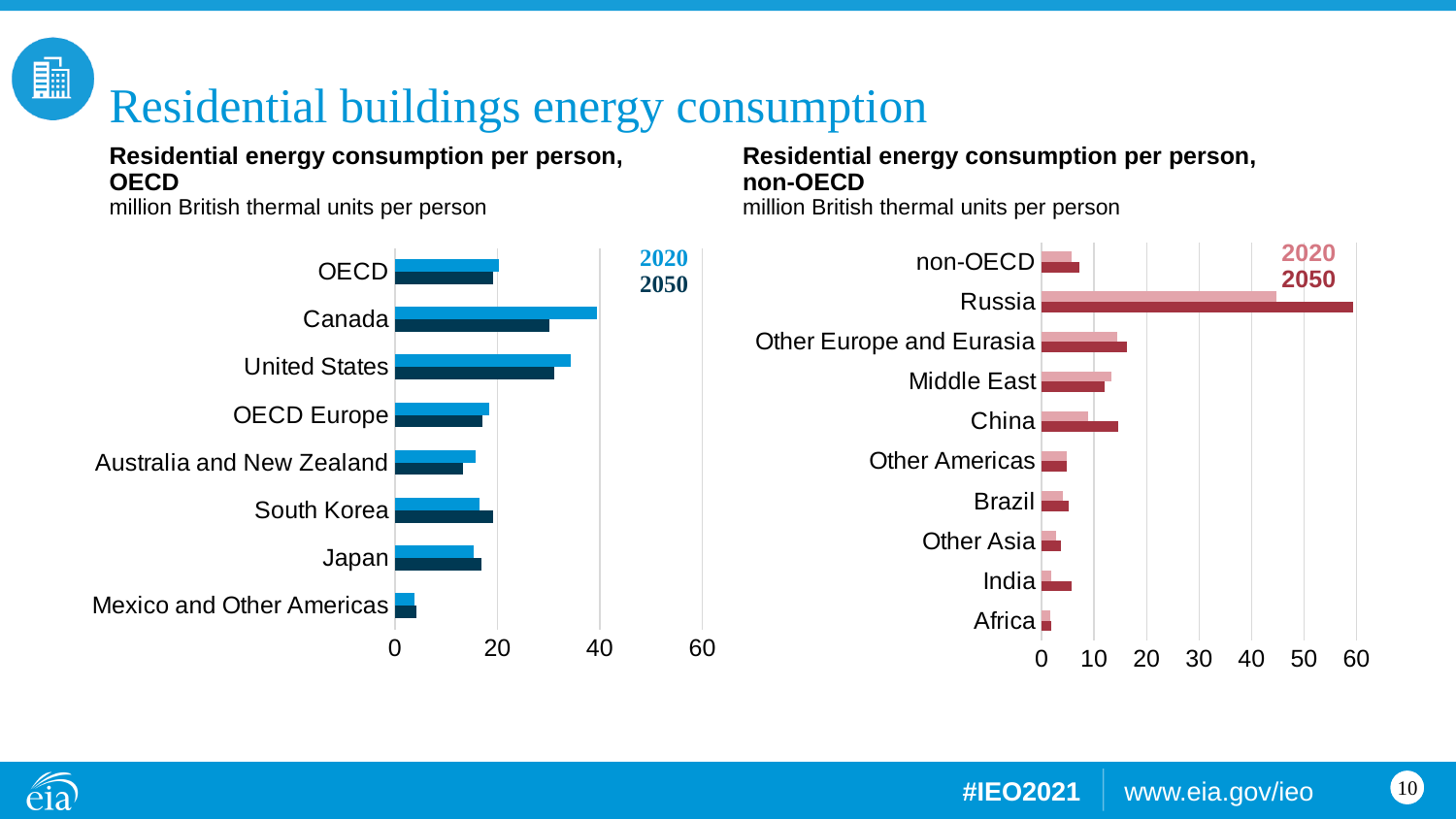
In the 'Residential energy consumption per person, non-OECD' chart, which category has the lowest 2020 value? Africa In the 'Residential energy consumption per person, OECD' chart, which is larger for Canada: the 2020 value or the 2050 value? 2020 In the 'Residential energy consumption per person, non-OECD' chart, is the 2050 value for Russia greater or less than 50? greater In the 'Residential energy consumption per person, OECD' chart, which category has the highest 2020 value? Canada In the 'Residential energy consumption per person, non-OECD' chart, is the 2050 value for Africa greater or less than 10? less What kind of chart is the 'Residential energy consumption per person, OECD' chart? Bar chart How many series does the legend of the 'Residential energy consumption per person, OECD' chart list? 2 In the 'Residential energy consumption per person, non-OECD' chart, which category has the highest 2050 value? Russia In the 'Residential energy consumption per person, OECD' chart, which category has the lowest 2020 value? Mexico and Other Americas How many categories are shown in the 'Residential energy consumption per person, non-OECD' chart? 10 In the 'Residential energy consumption per person, OECD' chart, is the 2020 value for Canada greater or less than 20? greater In the 'Residential energy consumption per person, non-OECD' chart, which is larger for China: the 2020 value or the 2050 value? 2050